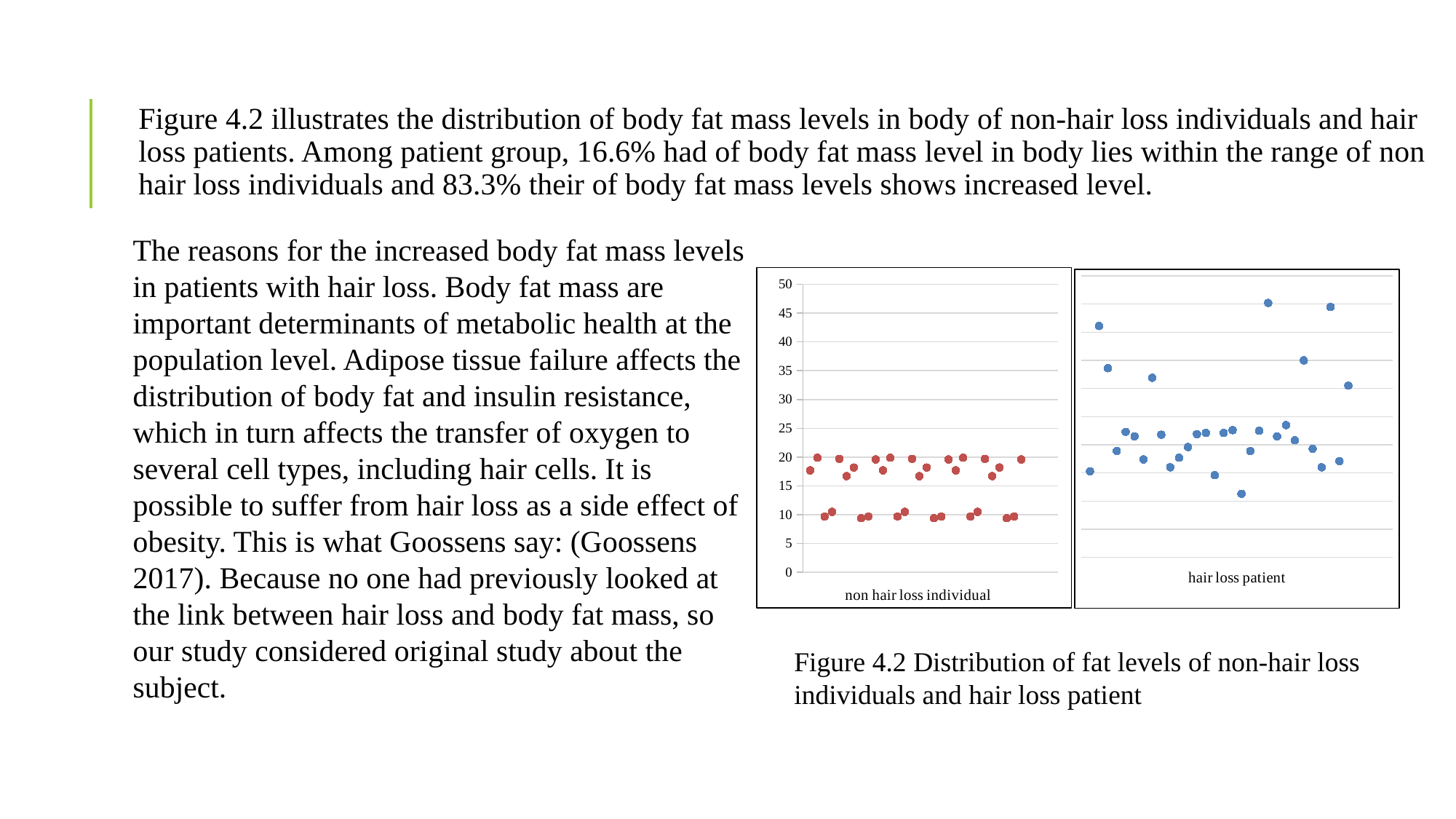
In the 'non hair loss individual' chart, is the highest plotted value greater or less than 30? less Which chart has the lower minimum plotted value, 'non hair loss individual' or 'hair loss patient'? non hair loss individual In the 'hair loss patient' chart, is the lowest plotted value greater or less than 15? less In the 'hair loss patient' chart, is the highest plotted value greater or less than 45? greater What kind of chart is the 'hair loss patient' chart? scatter chart What kind of chart is the 'non hair loss individual' chart? scatter chart Which chart has the higher maximum plotted value, 'non hair loss individual' or 'hair loss patient'? hair loss patient What colour are the points in the 'hair loss patient' chart? blue What is the highest tick value shown on the y axis of the 'non hair loss individual' chart? 50